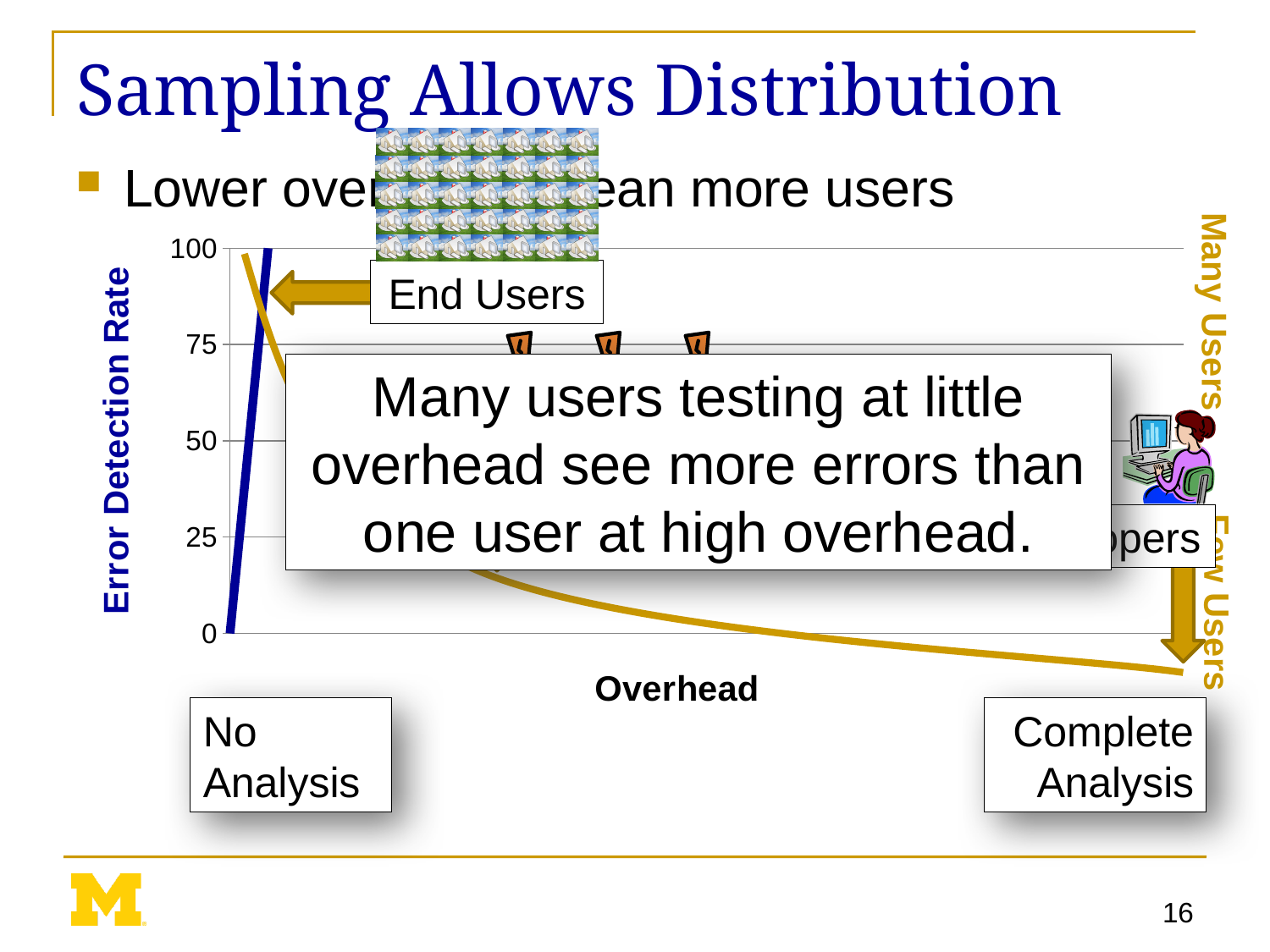
Is the value of the gold line at the far right end of the chart greater or less than 25? less How many tick labels are shown on the vertical axis? 5 What kind of chart is shown on the slide? line chart Is the value of the gold line at its left end (near the start of the chart) greater or less than 75? greater Does the blue line rise or fall as it moves to the right along the x axis? rise What is the highest tick value shown on the Error Detection Rate axis? 100 What is the label on the horizontal axis of the chart? Overhead Does the gold (yellow) line rise or fall as Overhead increases along the x axis? fall What is the label on the vertical axis of the chart? Error Detection Rate How many lines are plotted on the chart? 2